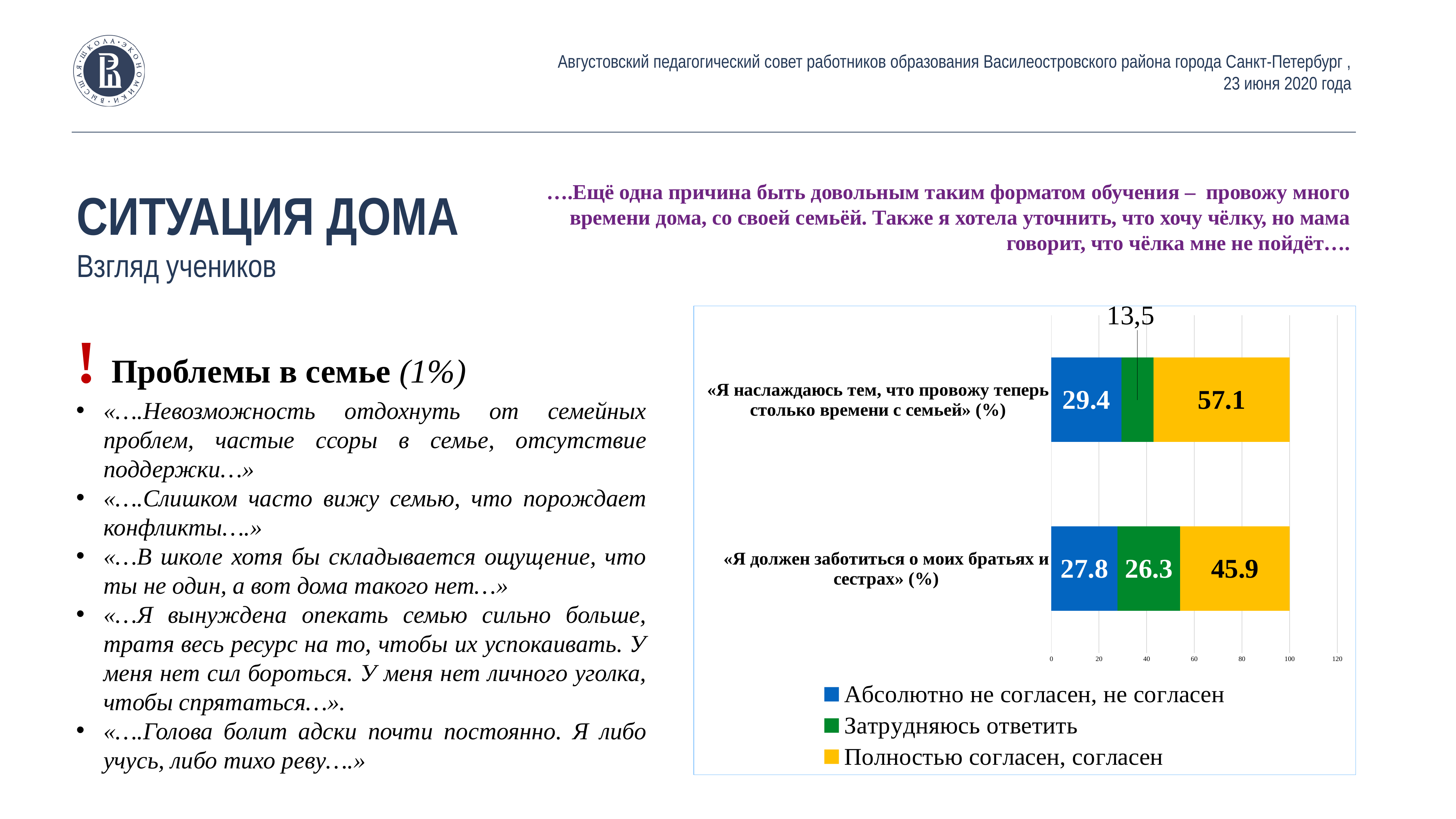
What is the value of «Абсолютно не согласен, не согласен» for the statement «Я должен заботиться о моих братьях и сестрах»? 27.8 Which statement has the larger «Полностью согласен, согласен» value? «Я наслаждаюсь тем, что провожу теперь столько времени с семьей» How many series does the chart legend list? 3 What is the value of «Полностью согласен, согласен» for the statement «Я наслаждаюсь тем, что провожу теперь столько времени с семьей»? 57.1 What colour represents the series «Затрудняюсь ответить» in the chart? green How many categories (statements) are plotted in the chart? 2 Which series has the lowest value for the statement «Я должен заботиться о моих братьях и сестрах»? Затрудняюсь ответить Which series has the highest value for the statement «Я наслаждаюсь тем, что провожу теперь столько времени с семьей»? Полностью согласен, согласен What is the difference between the «Полностью согласен, согласен» values for the two statements? 11.2 What is the value of «Затрудняюсь ответить» for the statement «Я должен заботиться о моих братьях и сестрах»? 26.3 What type of chart is shown on the slide? stacked bar chart What is the value of «Затрудняюсь ответить» for the statement «Я наслаждаюсь тем, что провожу теперь столько времени с семьей»? 13,5